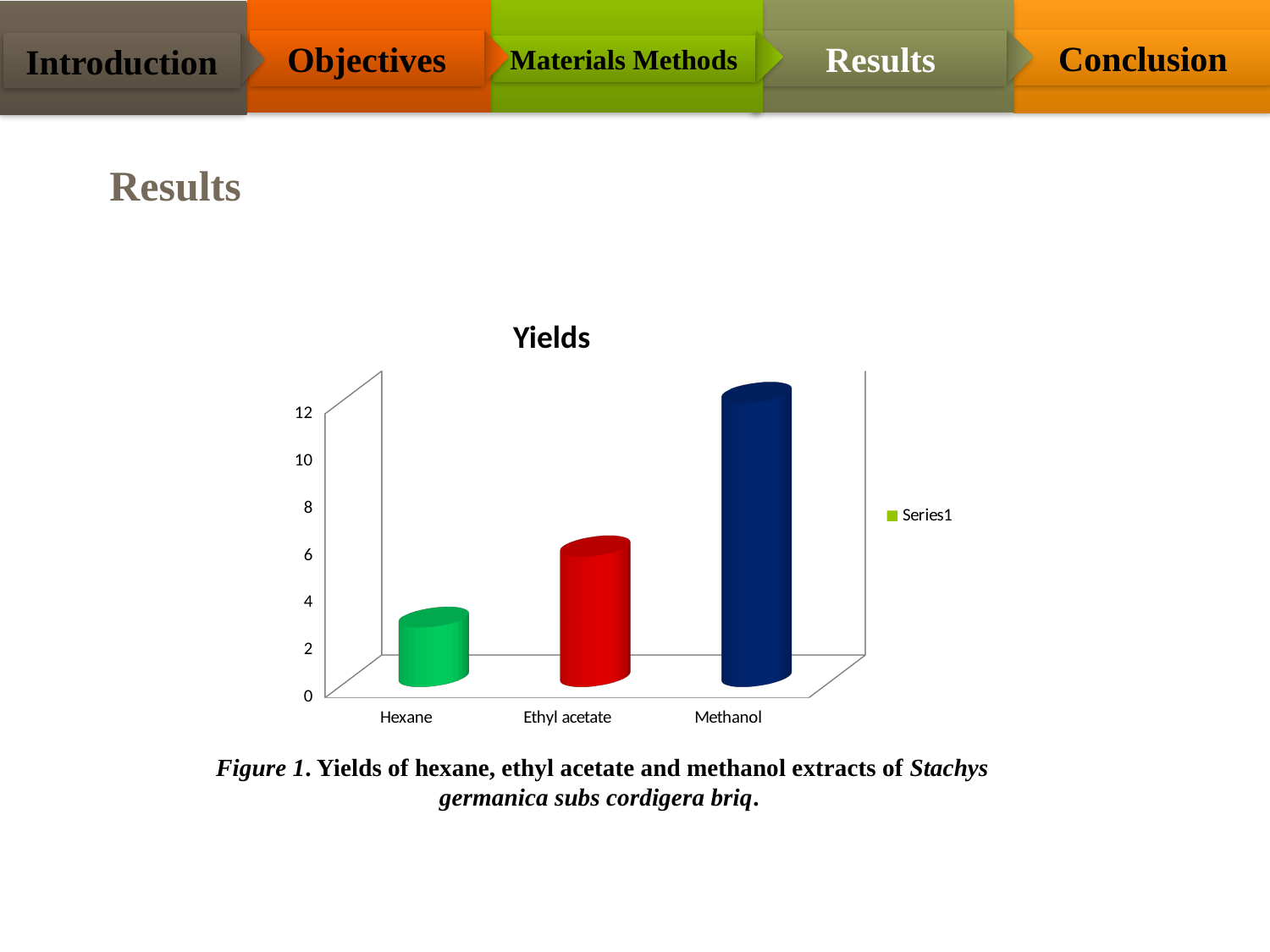
Which category has the lowest yield in the chart? Hexane Which has the larger yield, Ethyl acetate or Hexane? Ethyl acetate How many categories are plotted on the x axis of the chart? 3 What is the title of the chart? Yields Do the yields rise or fall moving from Hexane to Methanol along the x axis? rise What is the name of the series shown in the chart legend? Series1 Is the value for Hexane greater or less than 4? less Which category has the highest yield in the chart? Methanol Which has the larger yield, Methanol or Ethyl acetate? Methanol Is the value for Methanol greater or less than 10? greater What kind of chart is shown on the slide? bar chart How many series does the chart legend list? 1